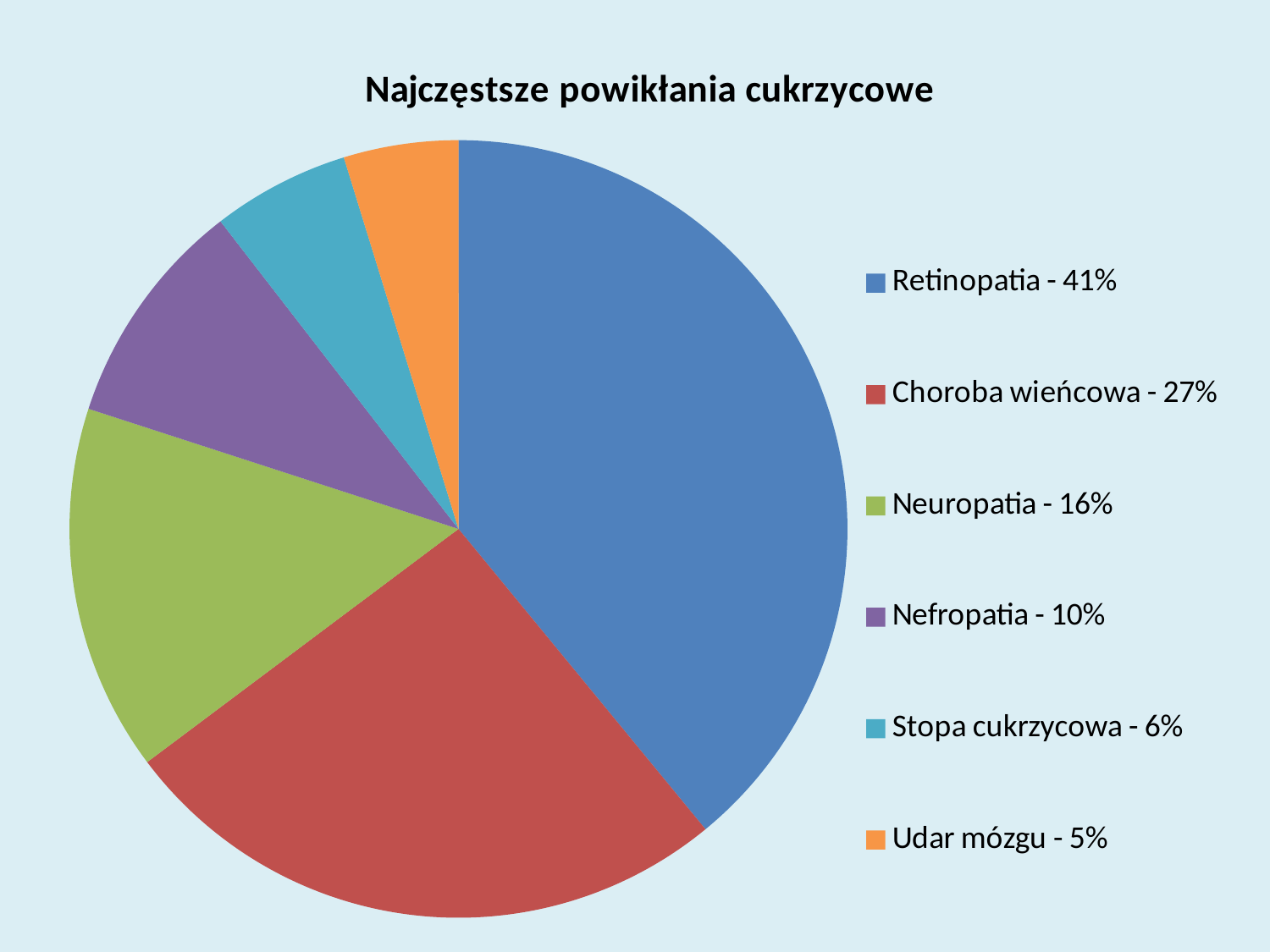
What type of chart is shown on the slide? pie chart What is the value shown for Stopa cukrzycowa? 6% Which category has the smallest slice of the pie? Udar mózgu Which category has the largest slice of the pie? Retinopatia What is the title of the chart? Najczęstsze powikłania cukrzycowe What is the difference between the shares of Retinopatia and Choroba wieńcowa? 14% How many slices does the pie chart have? 6 What is the value shown for Neuropatia? 16% What share of the pie does Retinopatia represent? 41% What colour is the slice for Udar mózgu? orange What is the value shown for Choroba wieńcowa? 27% Which is larger, the share for Nefropatia or the share for Neuropatia? Neuropatia